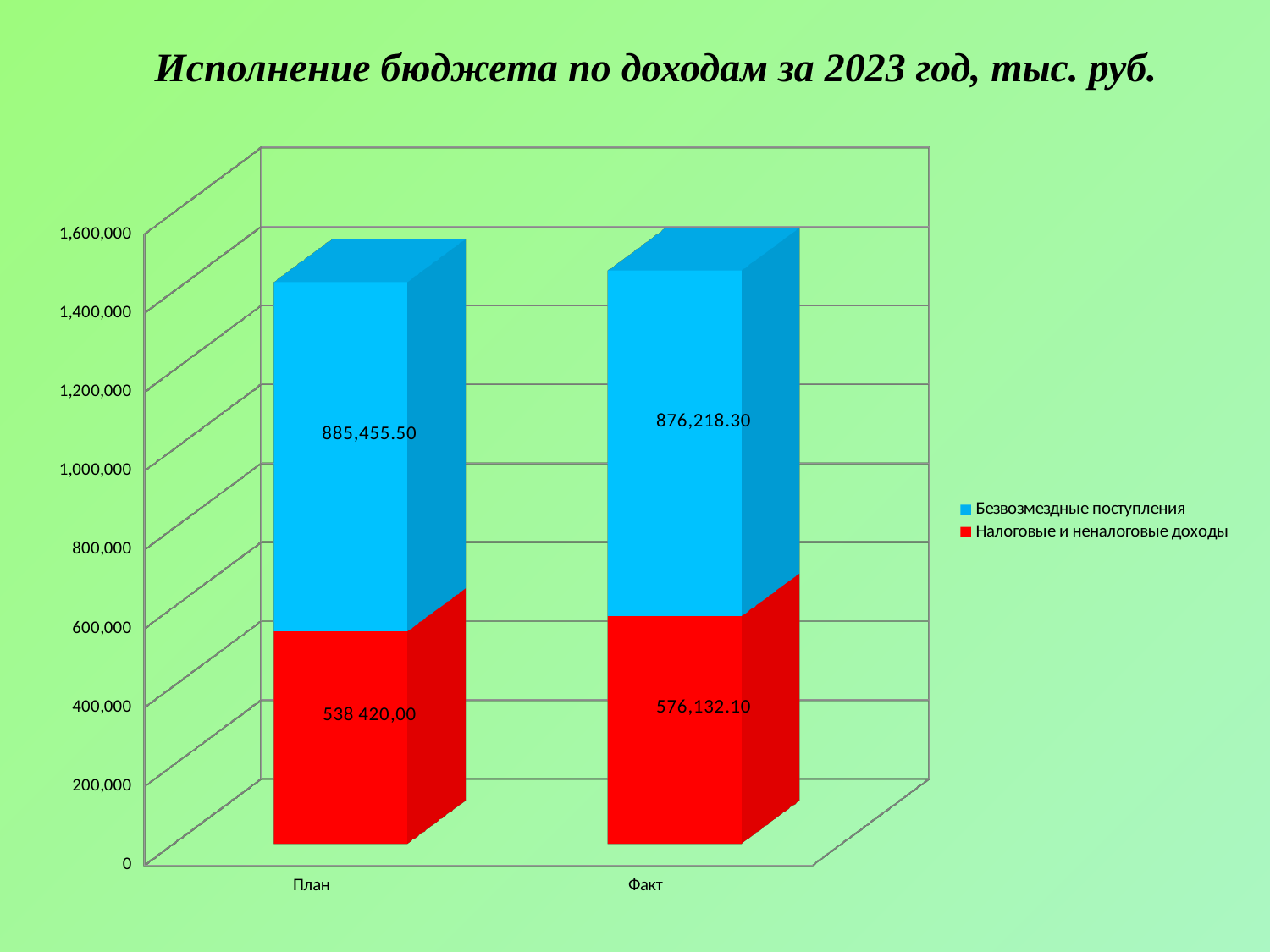
What is the difference between the Налоговые и неналоговые доходы values for Факт and План? 37,712.10 What is the value of Безвозмездные поступления for План? 885,455.50 What is the value of Налоговые и неналоговые доходы for Факт? 576,132.10 What kind of chart is shown on the slide? Stacked bar chart How many series does the legend list? 2 What is the value of Налоговые и неналоговые доходы for План? 538 420,00 Which category has the higher value for Налоговые и неналоговые доходы, План or Факт? Факт What is the difference between the Безвозмездные поступления values for План and Факт? 9,237.20 What is the total of the stacked bar for Факт? 1,452,350.40 What is the value of Безвозмездные поступления for Факт? 876,218.30 Which category has the higher value for Безвозмездные поступления, План or Факт? План How many categories are shown on the x axis? 2